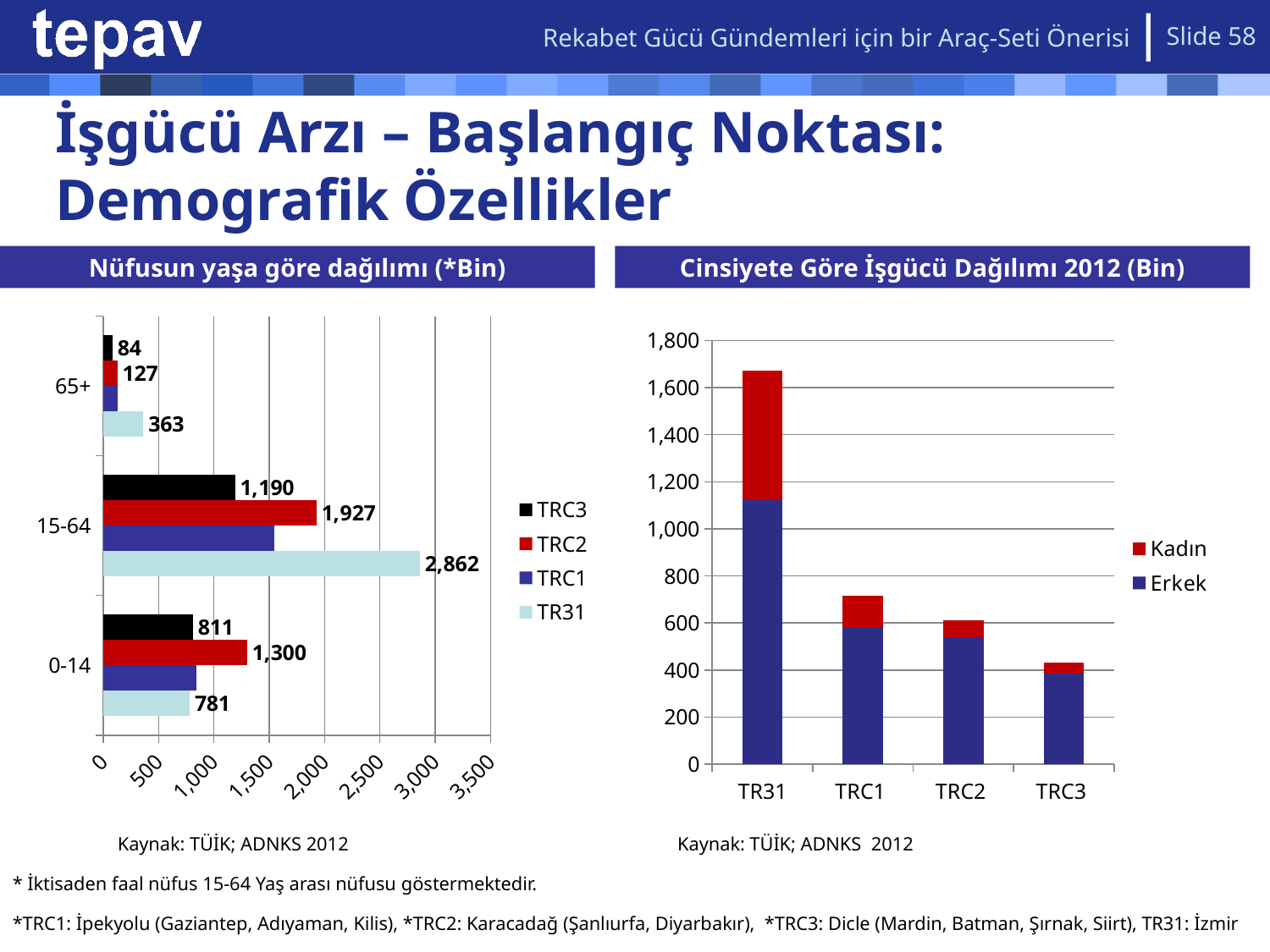
What kind of chart is 'Cinsiyete Göre İşgücü Dağılımı 2012 (Bin)'? Stacked bar chart In the chart 'Nüfusun yaşa göre dağılımı (*Bin)', which region has the highest value in the 15-64 age group? TR31 In the chart 'Cinsiyete Göre İşgücü Dağılımı 2012 (Bin)', which region has the lowest total labour force? TRC3 How many series does the legend of the chart 'Nüfusun yaşa göre dağılımı (*Bin)' list? 4 In the chart 'Nüfusun yaşa göre dağılımı (*Bin)', what is the value for TRC3 in the 65+ age group? 84 In the chart 'Nüfusun yaşa göre dağılımı (*Bin)', which is larger in the 0-14 age group: TRC2 or TR31? TRC2 In the chart 'Nüfusun yaşa göre dağılımı (*Bin)', what is the value for TRC2 in the 0-14 age group? 1,300 How many regions are shown on the x axis of the chart 'Cinsiyete Göre İşgücü Dağılımı 2012 (Bin)'? 4 In the chart 'Nüfusun yaşa göre dağılımı (*Bin)', what is the value for TR31 in the 15-64 age group? 2,862 In the chart 'Nüfusun yaşa göre dağılımı (*Bin)', what is the difference between TRC2 and TRC3 in the 15-64 age group? 737 In the chart 'Cinsiyete Göre İşgücü Dağılımı 2012 (Bin)', is the Erkek value for TR31 greater or less than 1,000? greater In the chart 'Cinsiyete Göre İşgücü Dağılımı 2012 (Bin)', which region has the highest total labour force? TR31